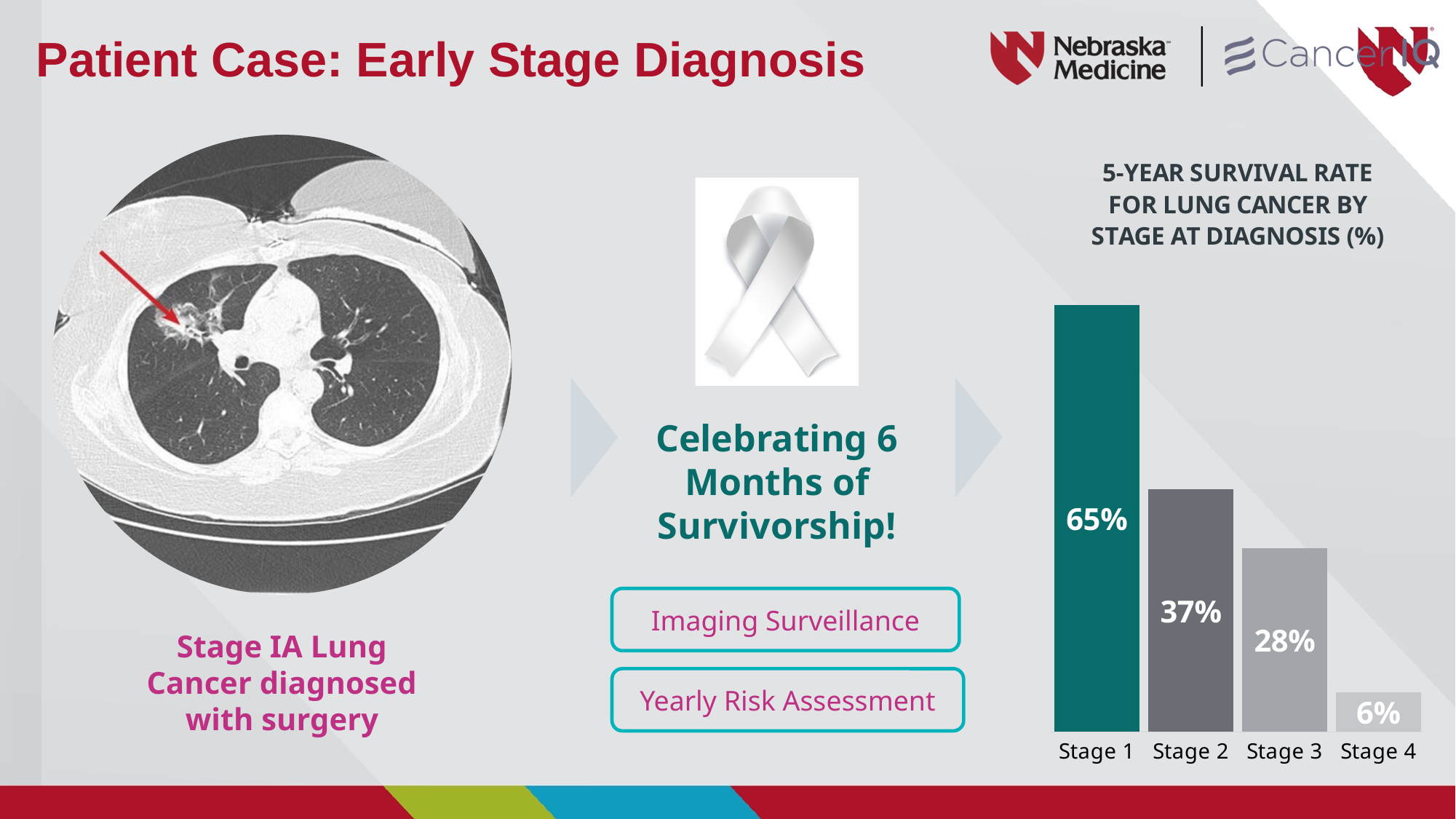
What is the difference in 5-year survival rate between Stage 1 and Stage 2? 28% What is the difference in 5-year survival rate between Stage 3 and Stage 4? 22% What is the 5-year survival rate shown for Stage 3? 28% Which has a higher 5-year survival rate, Stage 2 or Stage 3? Stage 2 Which stage has the highest 5-year survival rate? Stage 1 What is the 5-year survival rate shown for Stage 4? 6% How many stages are shown in the chart? 4 What kind of chart is used to show the 5-year survival rates? Bar chart Which stage has the lowest 5-year survival rate? Stage 4 What is the 5-year survival rate shown for Stage 1? 65% What is the 5-year survival rate shown for Stage 2? 37% Do the 5-year survival rates rise or fall from Stage 1 to Stage 4? Fall